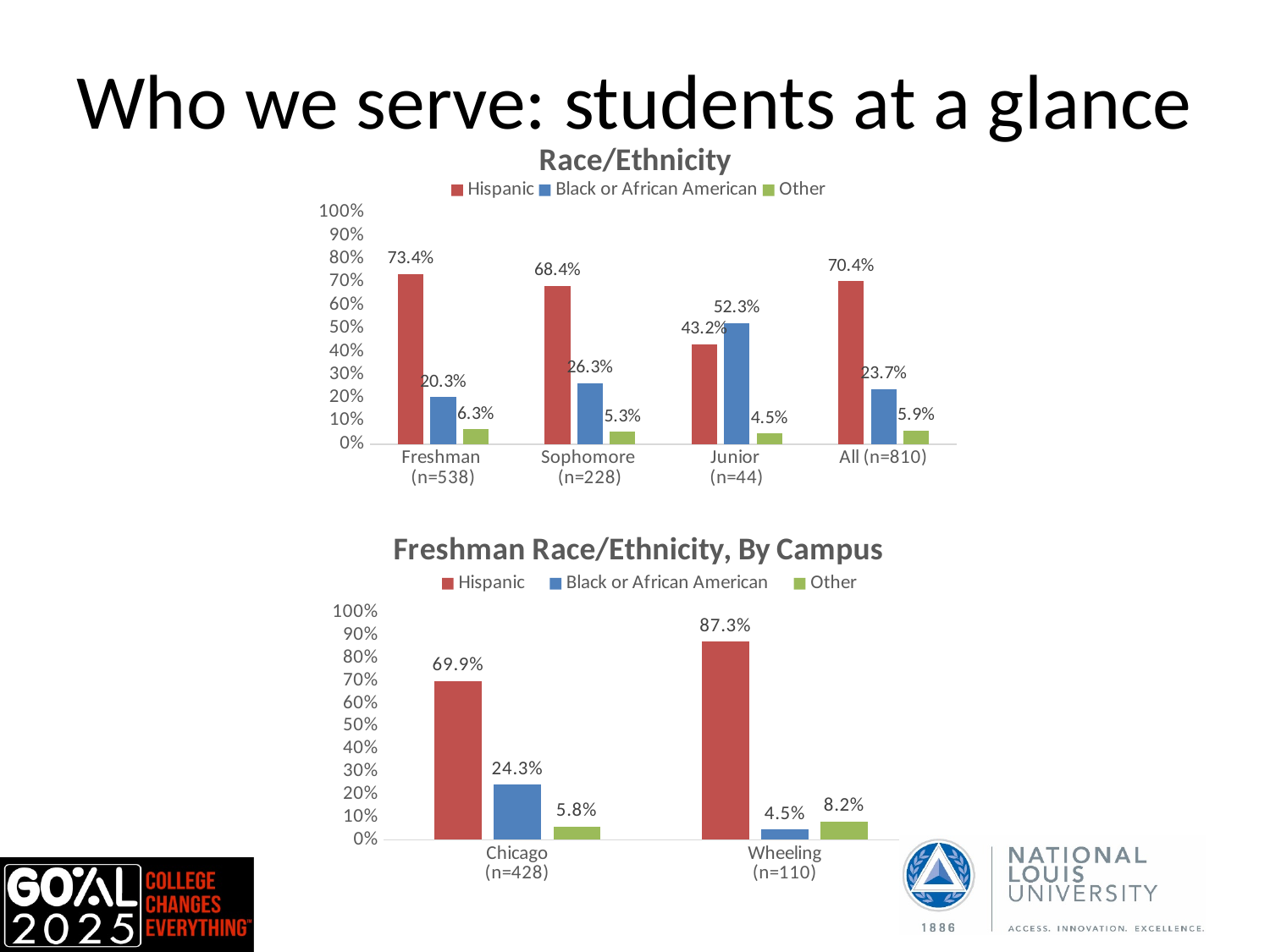
How many categories are shown on the x axis of the Race/Ethnicity chart? 4 What kind of chart is the Freshman Race/Ethnicity, By Campus chart? Bar chart In the Race/Ethnicity chart, which is larger for Junior (n=44): the Hispanic value or the Black or African American value? Black or African American In the Race/Ethnicity chart, what is the Black or African American value for Junior (n=44)? 52.3% In the Race/Ethnicity chart, which category has the lowest Hispanic value? Junior (n=44) In the Freshman Race/Ethnicity, By Campus chart, what is the Hispanic value for Wheeling (n=110)? 87.3% In the Race/Ethnicity chart, what is the difference between the Hispanic values for Freshman (n=538) and Sophomore (n=228)? 5.0% In the Race/Ethnicity chart, what is the Other value for All (n=810)? 5.9% How many series does the legend of the Freshman Race/Ethnicity, By Campus chart list? 3 In the Freshman Race/Ethnicity, By Campus chart, what is the difference between the Black or African American values for Chicago (n=428) and Wheeling (n=110)? 19.8% In the Race/Ethnicity chart, which category has the highest Black or African American value? Junior (n=44) In the Race/Ethnicity chart, what is the Hispanic value for Freshman (n=538)? 73.4%